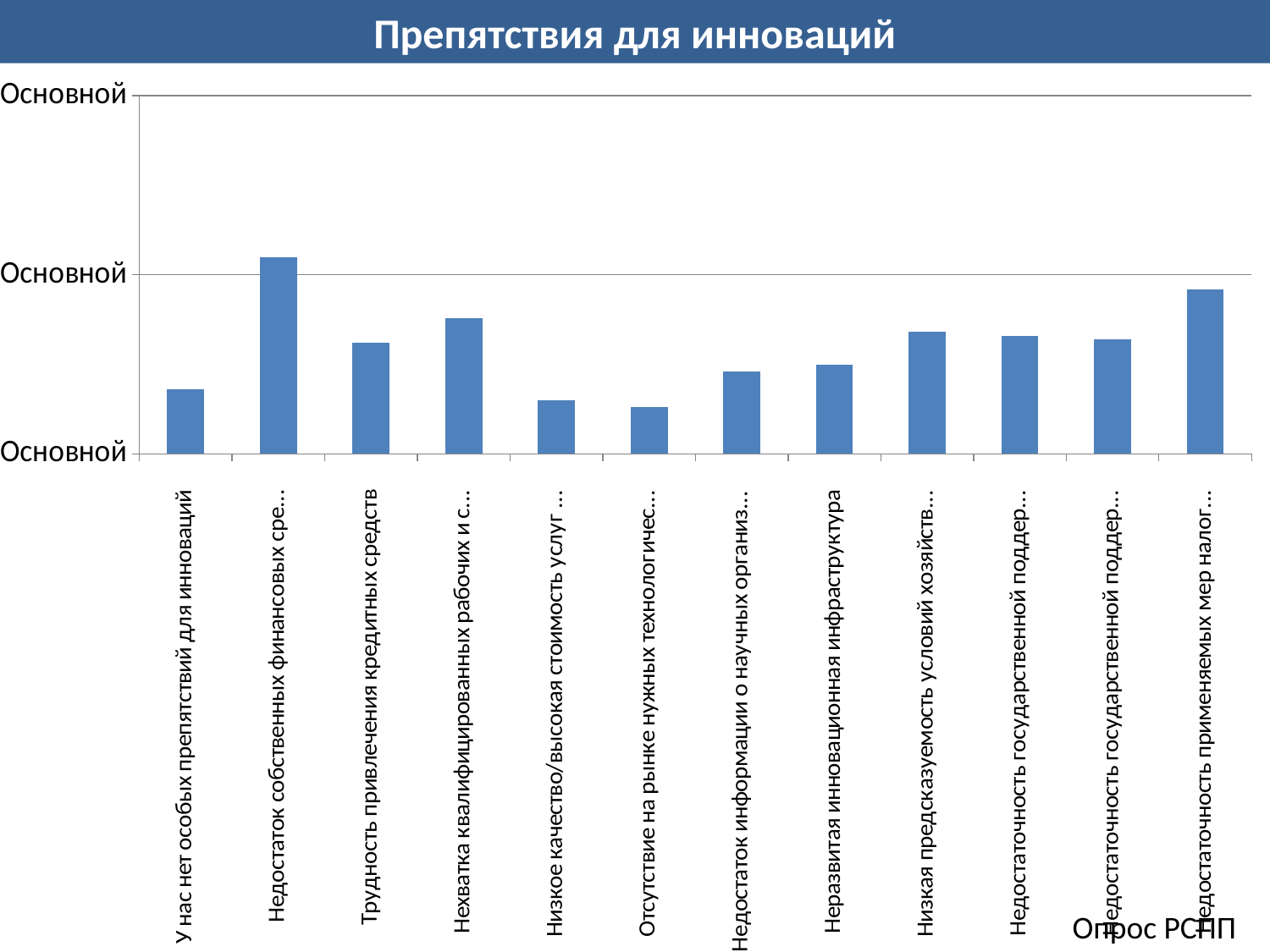
What kind of chart is shown on the slide? Bar chart What is the title of the chart? Препятствия для инноваций Which bar is taller: "Недостаток собственных финансовых сре..." or "Недостаточность применяемых мер налог..."? Недостаток собственных финансовых сре... Do the bar values rise steadily from left to right across the categories? No Which category has the second highest bar? Недостаточность применяемых мер налог... What source is cited in the bottom right corner of the slide? Опрос РСПП Which bar is taller: "Трудность привлечения кредитных средств" or "Нехватка квалифицированных рабочих и с..."? Нехватка квалифицированных рабочих и с... How many bars (categories) does the chart show? 12 Which category has the highest bar? Недостаток собственных финансовых сре... Which bar is taller: "У нас нет особых препятствий для инноваций" or "Неразвитая инновационная инфраструктура"? Неразвитая инновационная инфраструктура